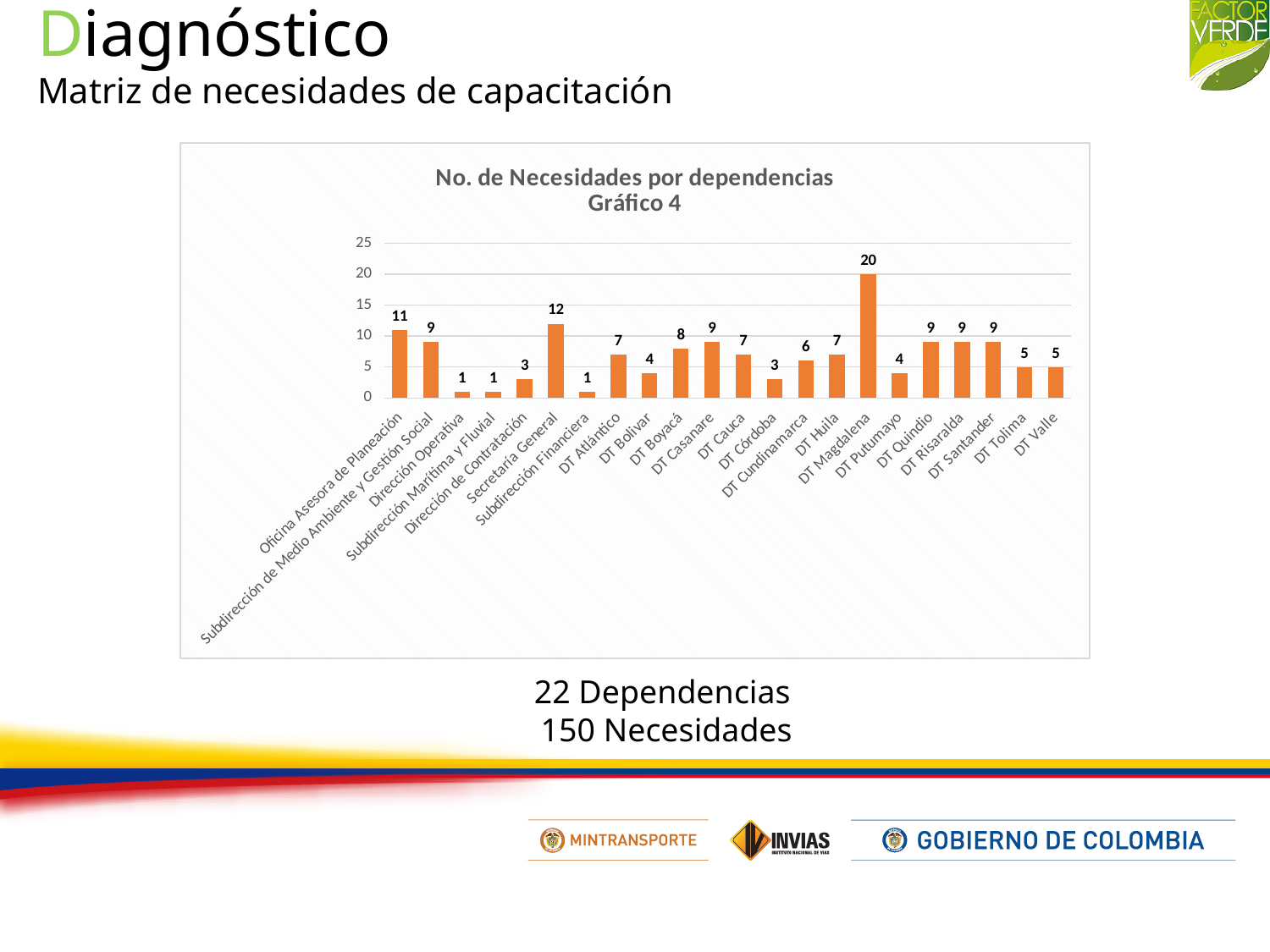
What is the value for Secretaría General? 12 What is the title of the chart? No. de Necesidades por dependencias Gráfico 4 What is the value for DT Cundinamarca? 6 What is the value for DT Magdalena? 20 Which dependencia has the highest number of necesidades? DT Magdalena What is the difference between the values for DT Magdalena and Secretaría General? 8 How many dependencias (categories) are plotted in the chart? 22 What type of chart is shown on the slide? bar chart Is the value for DT Magdalena greater or less than 15? greater Which has a larger value, DT Boyacá or DT Bolívar? DT Boyacá What is the lowest value shown in the chart? 1 What is the value for Oficina Asesora de Planeación? 11